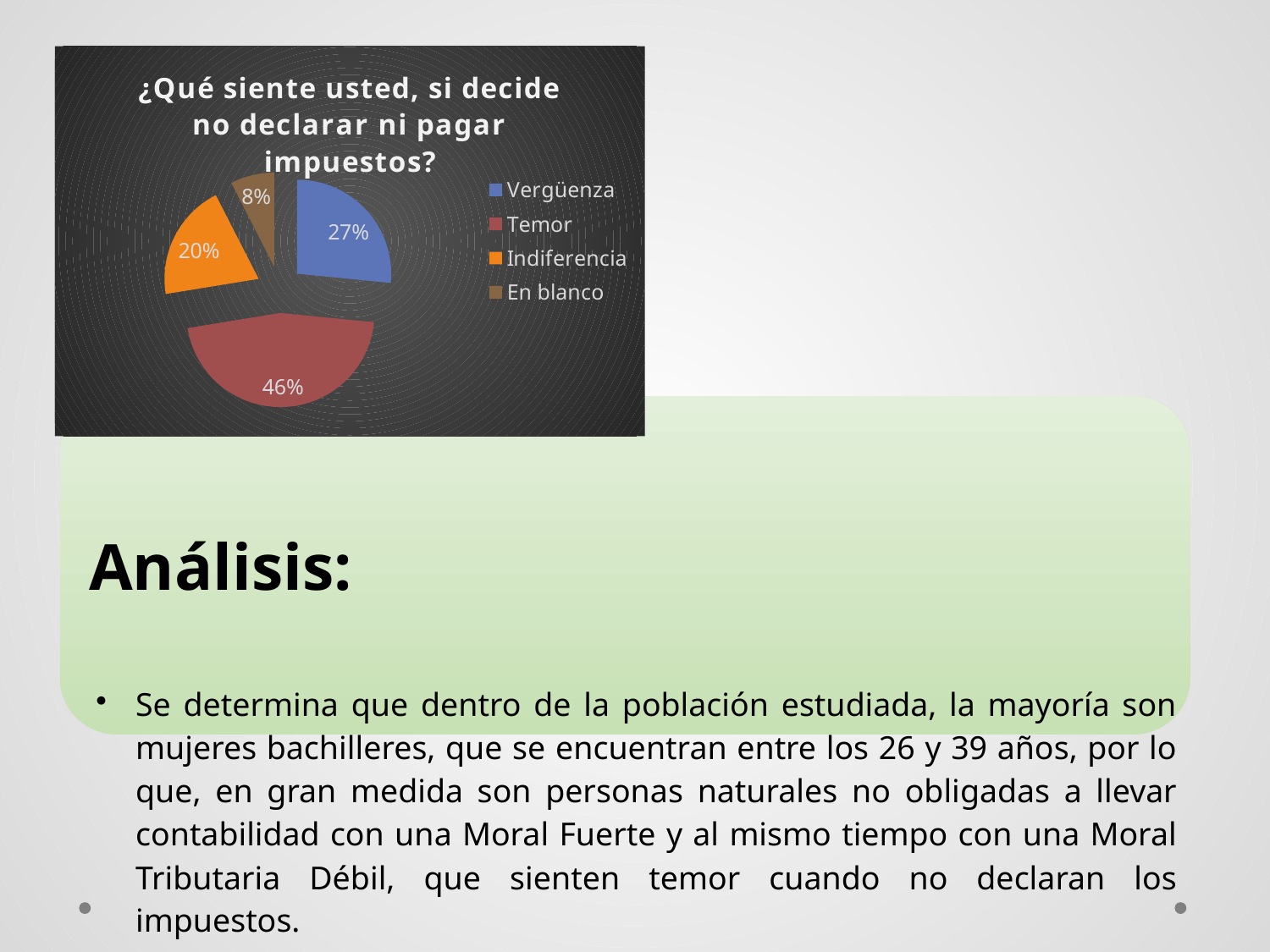
What is the difference in percentage points between Temor and Vergüenza? 19 What percentage of the pie corresponds to Temor? 46% What percentage of the pie corresponds to Vergüenza? 27% Which is larger, the share for Indiferencia or the share for En blanco? Indiferencia How many categories does the legend list? 4 What is the title of the chart? ¿Qué siente usted, si decide no declarar ni pagar impuestos? What percentage of the pie corresponds to En blanco? 8% Which category has the largest share of the pie? Temor What colour is the slice for Indiferencia? orange Which category has the smallest share of the pie? En blanco What percentage of the pie corresponds to Indiferencia? 20% What type of chart is shown on the slide? pie chart